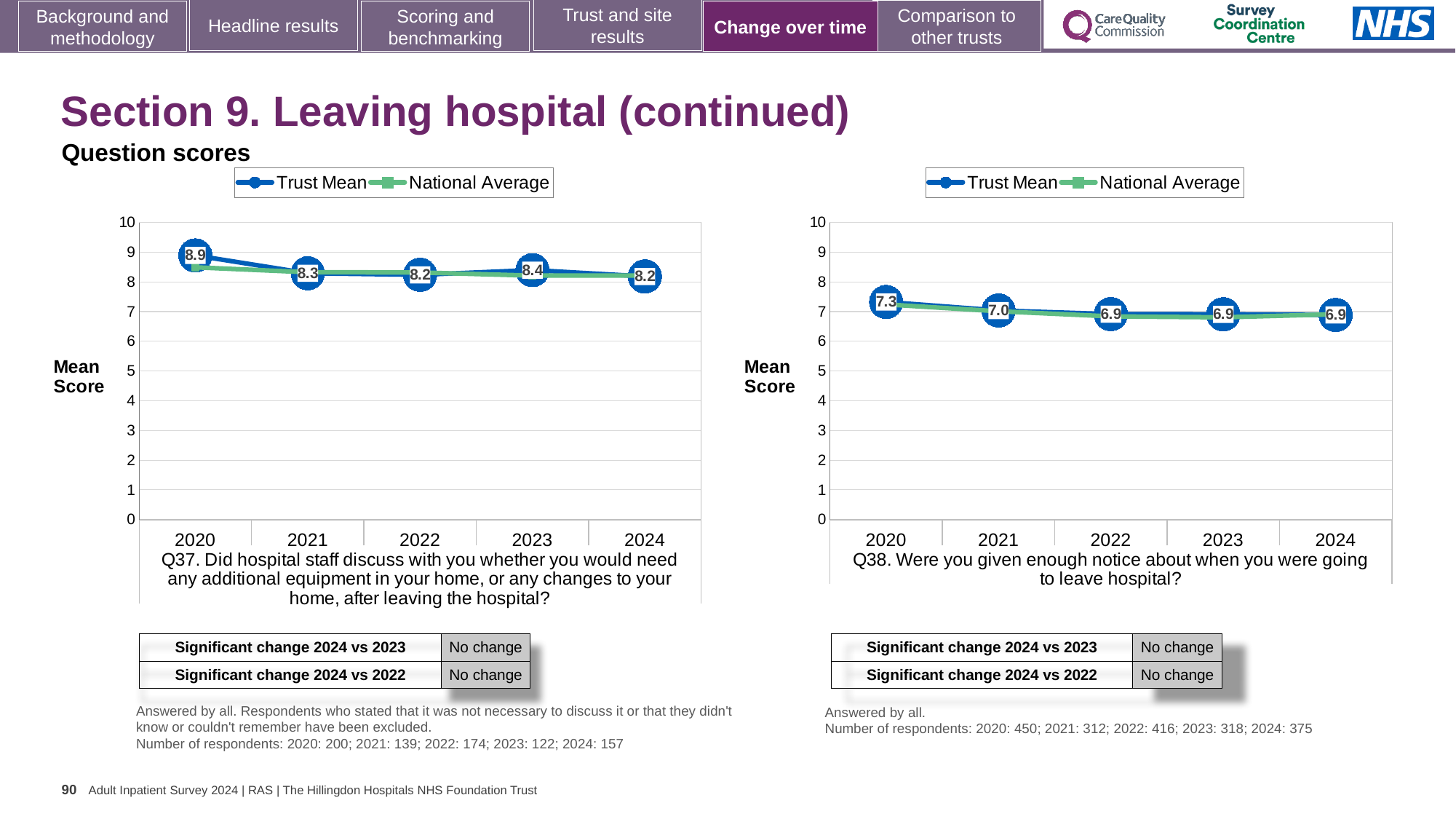
How many series does the legend of the Q37 chart on the left list? 2 How many years are plotted on the x axis of the Q38 chart on the right? 5 In the Q37 chart on the left, is the National Average value for 2020 greater or less than 8? greater What type of chart is the Q38 chart on the right? Line chart In the Q38 chart on the right, what is the Trust Mean score for 2024? 6.9 In the Q37 chart on the left, which year has the highest Trust Mean score? 2020 In the Q38 chart on the right, which is larger, the Trust Mean score for 2020 or for 2021? 2020 In the Q38 chart on the right, what is the Trust Mean score for 2020? 7.3 In the Q38 chart on the right, which year has the highest Trust Mean score? 2020 In the Q37 chart on the left, what is the Trust Mean score for 2020? 8.9 In the Q37 chart on the left, what is the Trust Mean score for 2023? 8.4 In the Q37 chart on the left, what is the difference between the Trust Mean scores for 2020 and 2024? 0.7